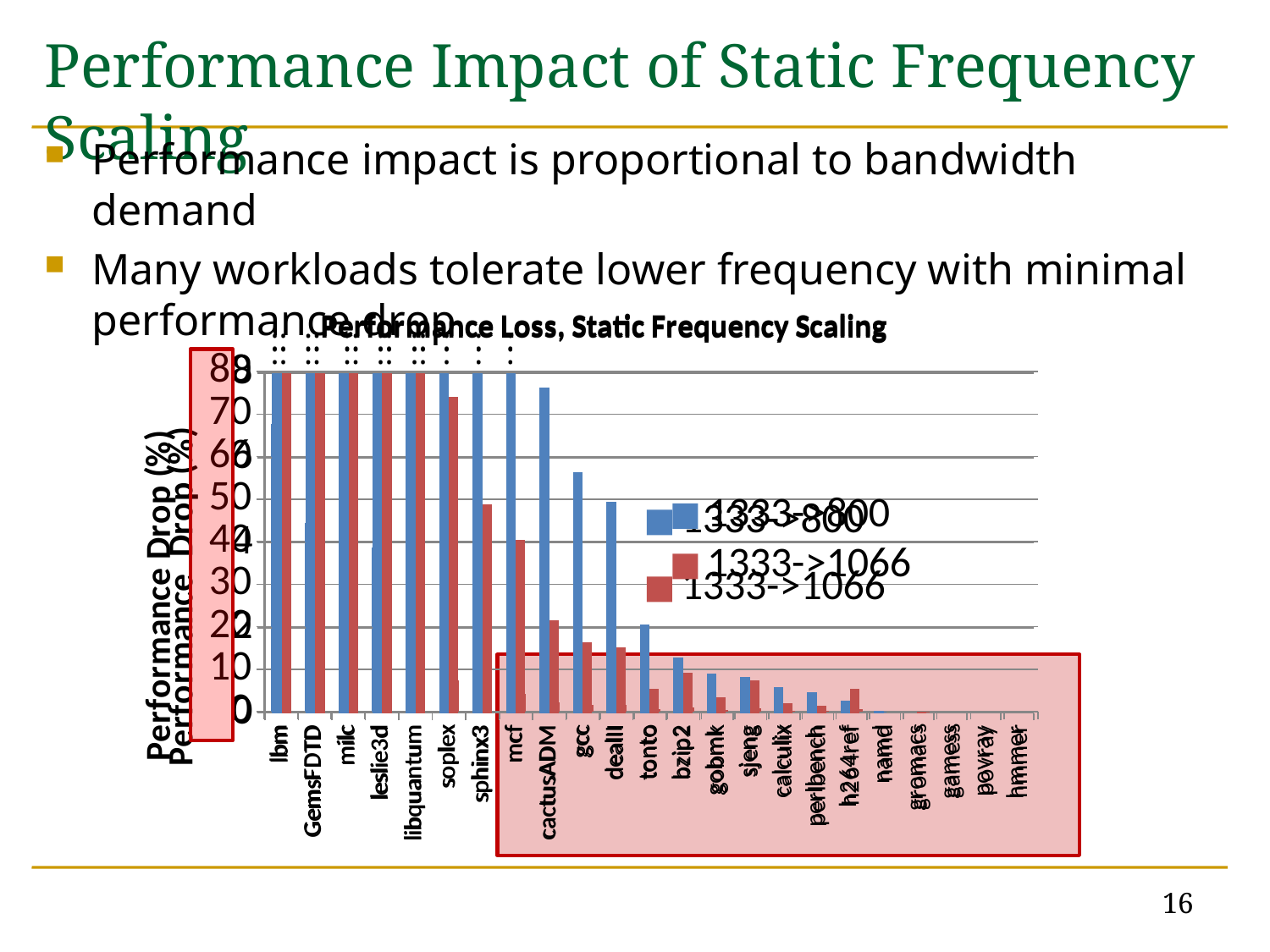
What is the title of the chart? Performance Loss, Static Frequency Scaling How many workload categories are shown on the x axis of the chart? 23 How many series does the chart legend list? 2 Is the 1333->800 value for namd greater or less than 10? less Which series is drawn in red in the chart? 1333->1066 What kind of chart is shown on the slide? bar chart For the 1333->1066 series, which is larger: soplex or sphinx3? soplex Do the 1333->800 values rise or fall moving from left to right along the x axis? fall For the 1333->800 series, which is larger: gcc or dealII? gcc